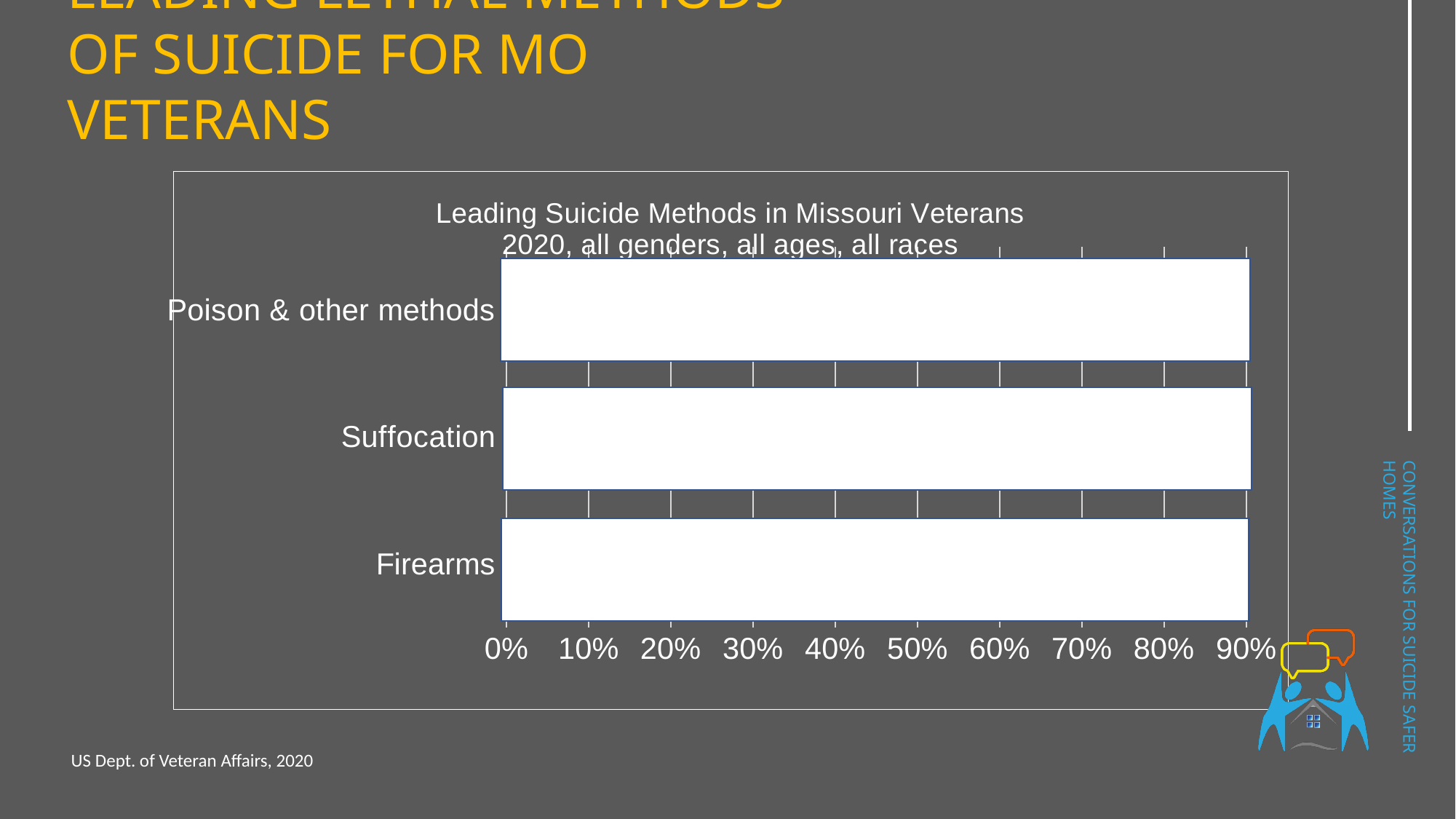
Is the value for Firearms greater or less than 50%? greater What kind of chart is shown on the slide? bar chart What is the interval between tick labels on the horizontal axis of the chart? 10% What is the highest value shown on the horizontal axis of the chart? 90% What is the title of the chart? Leading Suicide Methods in Missouri Veterans 2020, all genders, all ages, all races Which category is listed at the bottom of the chart? Firearms How many categories (suicide methods) are plotted in the chart? 3 What is the lowest value shown on the horizontal axis of the chart? 0%